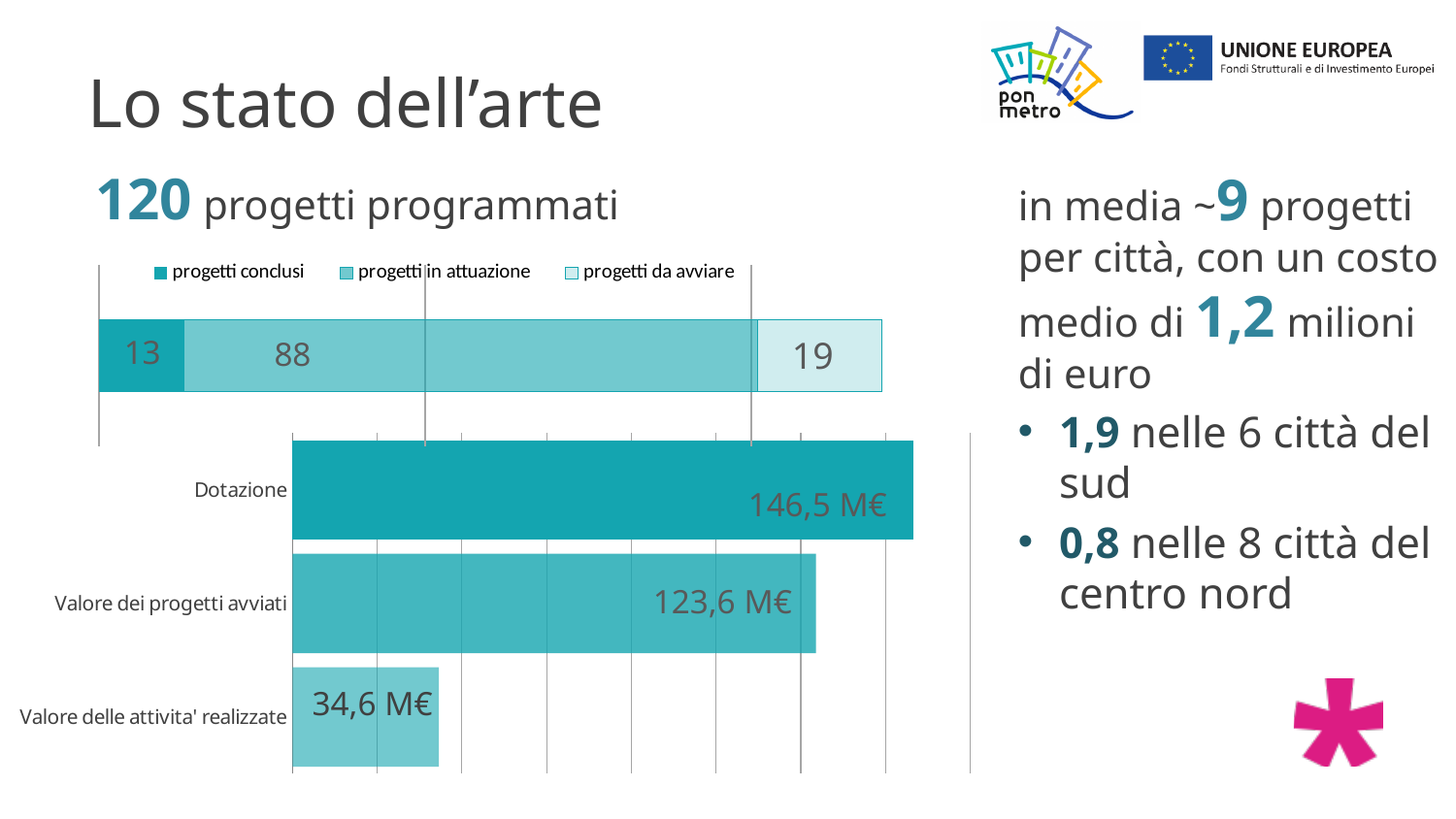
In the bottom bar chart, how many categories are shown? 3 How many series does the legend of the top stacked bar chart list? 3 In the top stacked bar chart, what is the value for progetti da avviare? 19 In the bottom bar chart, what is the difference between Dotazione and Valore dei progetti avviati? 22,9 M€ In the bottom bar chart, what is the value for Valore delle attivita' realizzate? 34,6 M€ In the top stacked bar chart, what is the total of the stacked bar? 120 In the top stacked bar chart, what is the value for progetti in attuazione? 88 In the top stacked bar chart, which segment is the largest? progetti in attuazione In the bottom bar chart, which category has the lowest value? Valore delle attivita' realizzate In the bottom bar chart, what is the value for Dotazione? 146,5 M€ What kind of chart is the bottom chart on the slide? bar chart In the top stacked bar chart, what is the value for progetti conclusi? 13